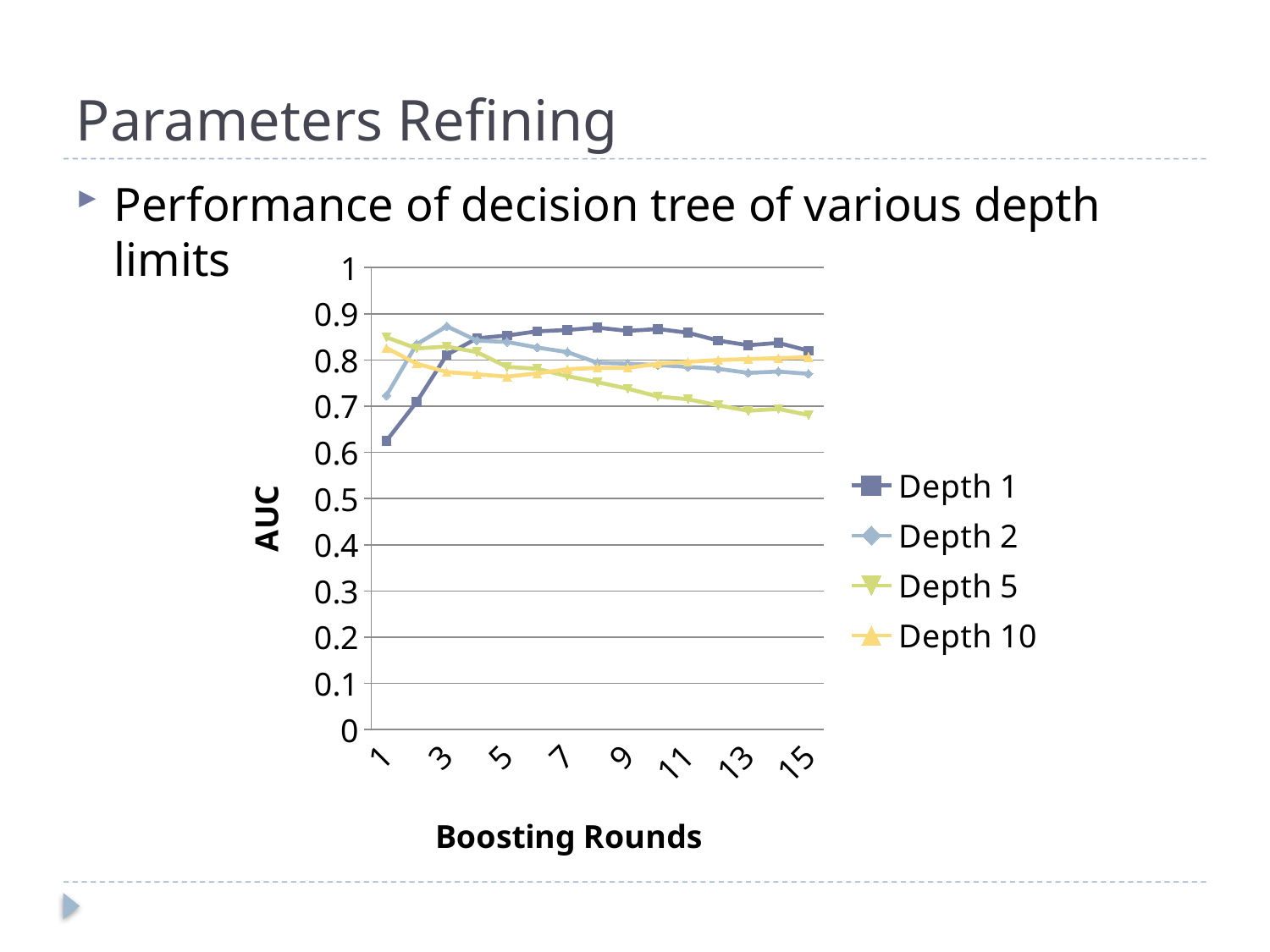
Is the AUC for Depth 5 at boosting round 15 greater or less than 0.8? less Does the AUC for Depth 5 rise or fall from boosting round 1 to round 15? fall How many series does the legend list? 4 Is the AUC for Depth 1 at boosting round 8 greater or less than 0.8? greater Is the AUC for Depth 1 at boosting round 1 greater or less than 0.7? less Which series has the lowest AUC at boosting round 15? Depth 5 What kind of chart is shown on the slide? line chart Which series has the lowest AUC at boosting round 1? Depth 1 At boosting round 1, which has the higher AUC, Depth 5 or Depth 2? Depth 5 At boosting round 15, which has the higher AUC, Depth 1 or Depth 5? Depth 1 How many boosting rounds are plotted along the x axis for each series? 15